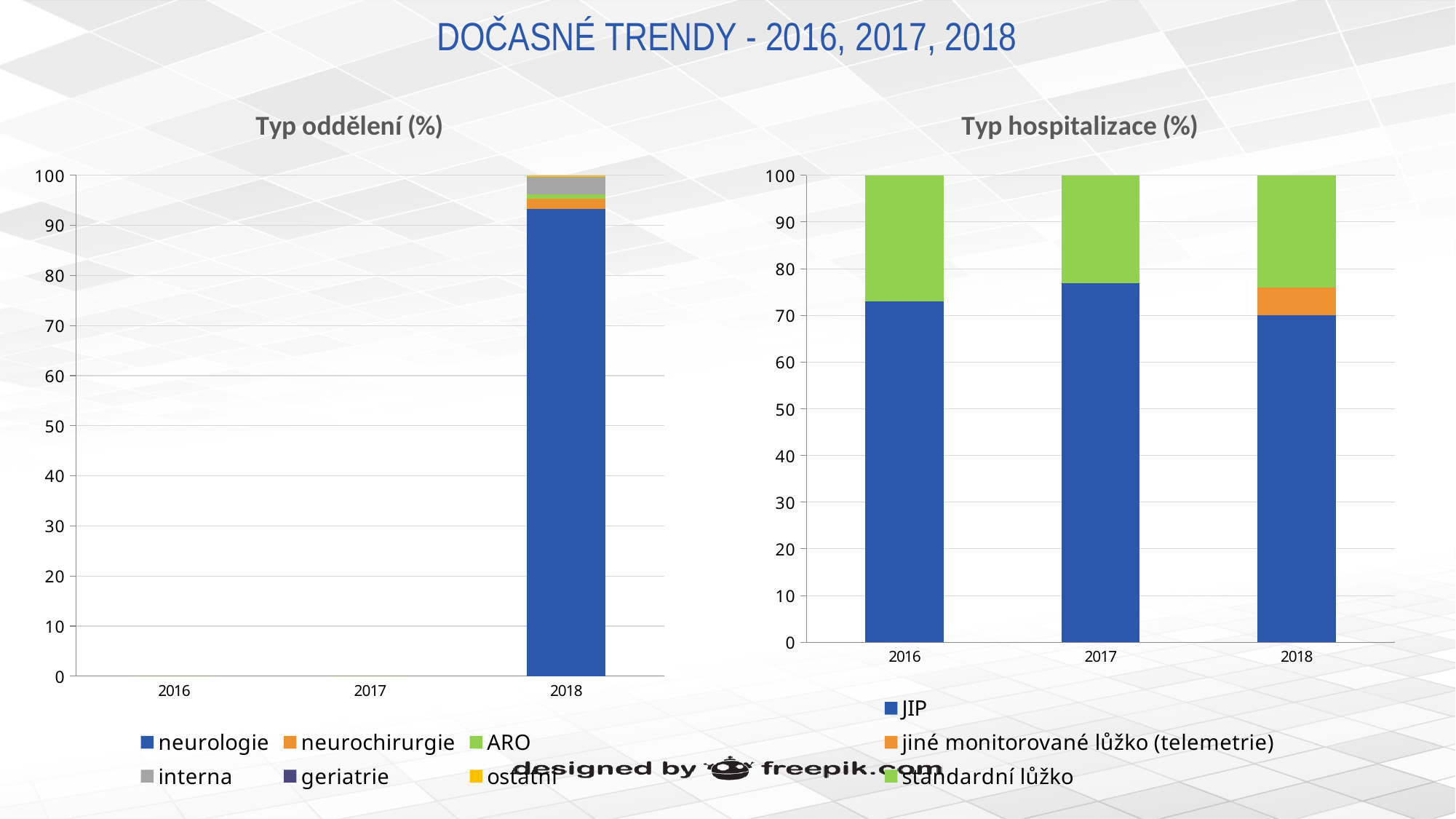
In the "Typ hospitalizace (%)" chart, is the JIP value for 2016 greater or less than 70? greater What kind of chart is the "Typ hospitalizace (%)" chart? stacked bar chart How many series does the legend of the "Typ hospitalizace (%)" chart list? 3 In the "Typ hospitalizace (%)" chart, which year has the lowest JIP share? 2018 In the "Typ oddělení (%)" chart, is the neurologie value for 2018 greater or less than 90? greater How many years are shown on the x axis of the "Typ hospitalizace (%)" chart? 3 In the "Typ oddělení (%)" chart, which year is the only one with a visible bar? 2018 In the "Typ hospitalizace (%)" chart, is the JIP share larger in 2016 or in 2017? 2017 In the "Typ hospitalizace (%)" chart, is the JIP value for 2017 greater or less than 80? less In the "Typ hospitalizace (%)" chart, which year has the highest JIP share? 2017 How many series does the legend of the "Typ oddělení (%)" chart list? 6 In the "Typ hospitalizace (%)" chart, which year is the only one with a "jiné monitorované lůžko (telemetrie)" segment? 2018